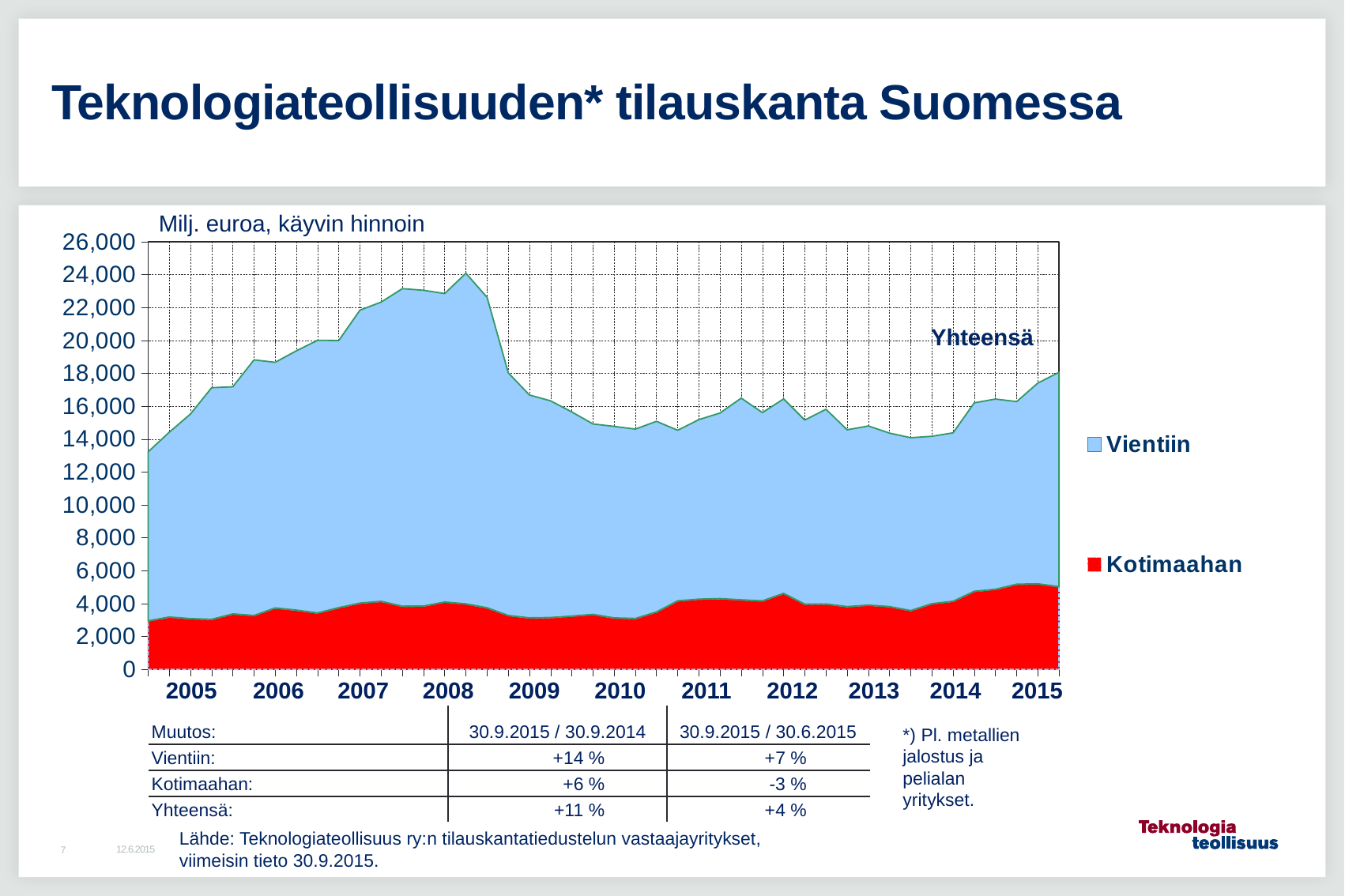
Is the total value at the end of 2015 greater or less than 16,000? greater How many series does the chart legend list? 2 What unit label is shown above the chart's y axis? Milj. euroa, käyvin hinnoin How many years are labelled on the chart's x axis? 11 In which year does the total (Yhteensä) order backlog reach its highest point? 2008 What kind of chart is shown on the slide? area chart What are the two series named in the chart legend? Vientiin and Kotimaahan Is the Kotimaahan value at the end of 2015 greater or less than 4,000? greater Does the total order backlog rise or fall between 2008 and 2009? fall Which series is larger throughout the chart, Vientiin or Kotimaahan? Vientiin Is the peak total value in 2008 greater or less than 20,000? greater